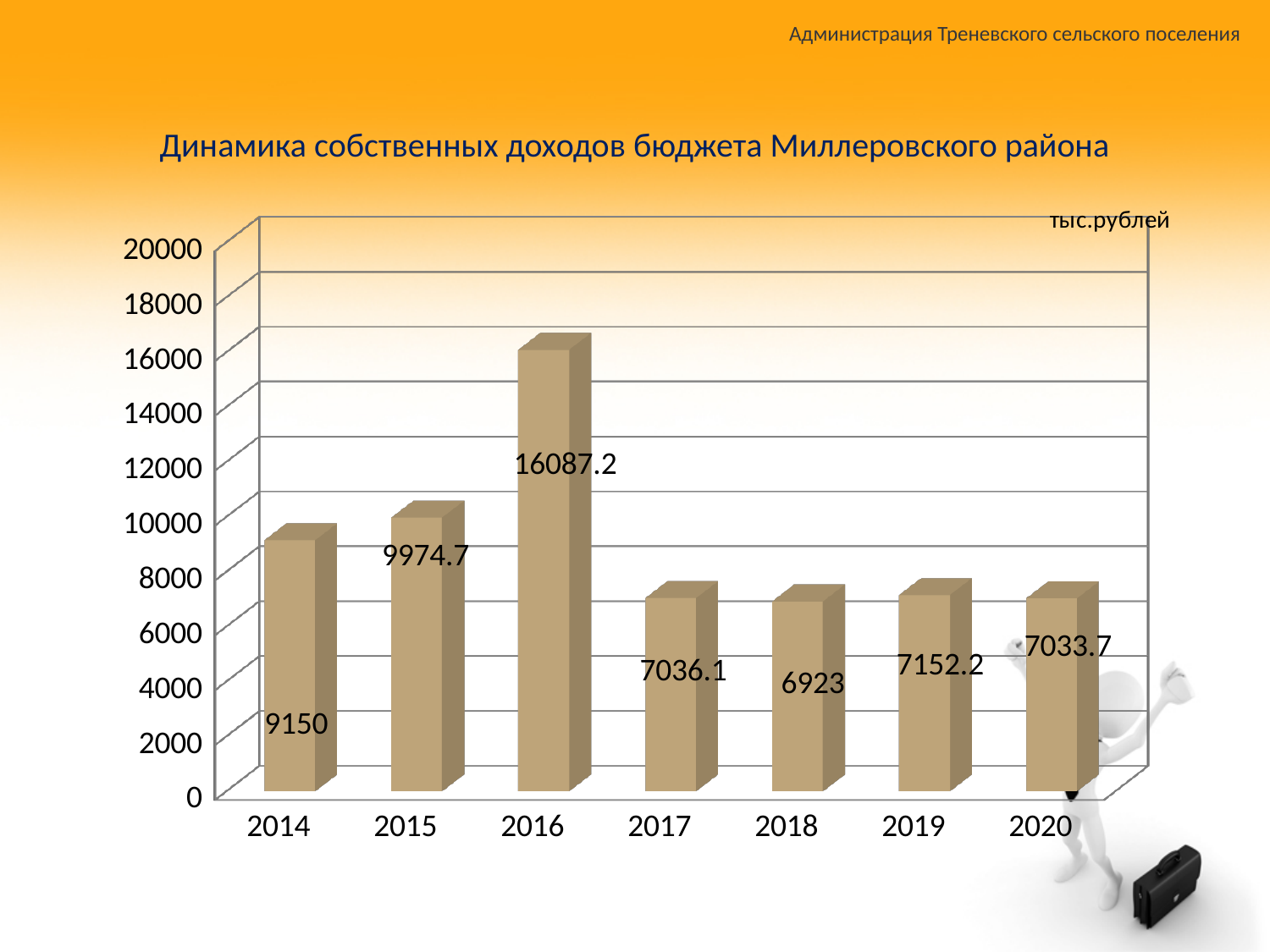
Which year has the lowest value? 2018 What is the difference between the values for 2016 and 2015? 6112.5 What is the value for 2016? 16087.2 Is the value for 2017 greater or less than 8000? less Which year has the highest value? 2016 What is the value for 2018? 6923 What is the value for 2014? 9150 How many years are shown on the x axis? 7 What is the difference between the values for 2019 and 2018? 229.2 What kind of chart is shown on the slide? bar chart What unit is indicated in the top right corner of the chart? тыс.рублей Which is larger, the value for 2015 or the value for 2014? 2015